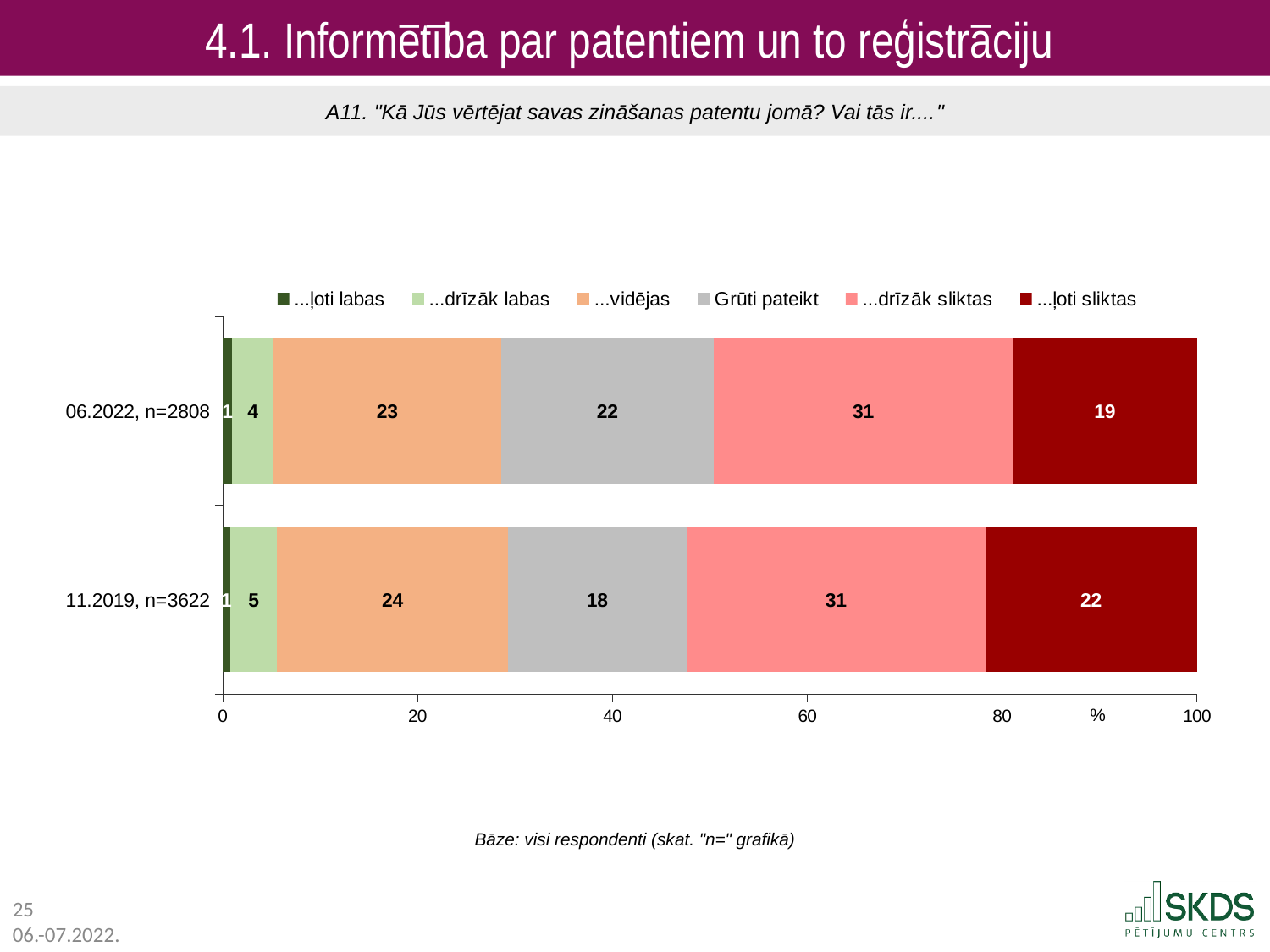
Which segment is the smallest in the 11.2019, n=3622 bar? ...ļoti labas What is the value for "Grūti pateikt" in the 11.2019, n=3622 bar? 18 How many series does the legend list? 6 What kind of chart is shown on the slide? Stacked bar chart Which segment is the largest in the 06.2022, n=2808 bar? ...drīzāk sliktas What is the value for "...drīzāk sliktas" in the 06.2022, n=2808 bar? 31 What is the value for "...ļoti sliktas" in the 06.2022, n=2808 bar? 19 Which bar has the larger "Grūti pateikt" value, 06.2022, n=2808 or 11.2019, n=3622? 06.2022, n=2808 What is the total of the segments in the 06.2022, n=2808 bar? 100 How many bars (survey waves) are plotted in the chart? 2 What is the value for "...drīzāk labas" in the 11.2019, n=3622 bar? 5 What is the difference between the "...ļoti sliktas" values for 11.2019, n=3622 and 06.2022, n=2808? 3